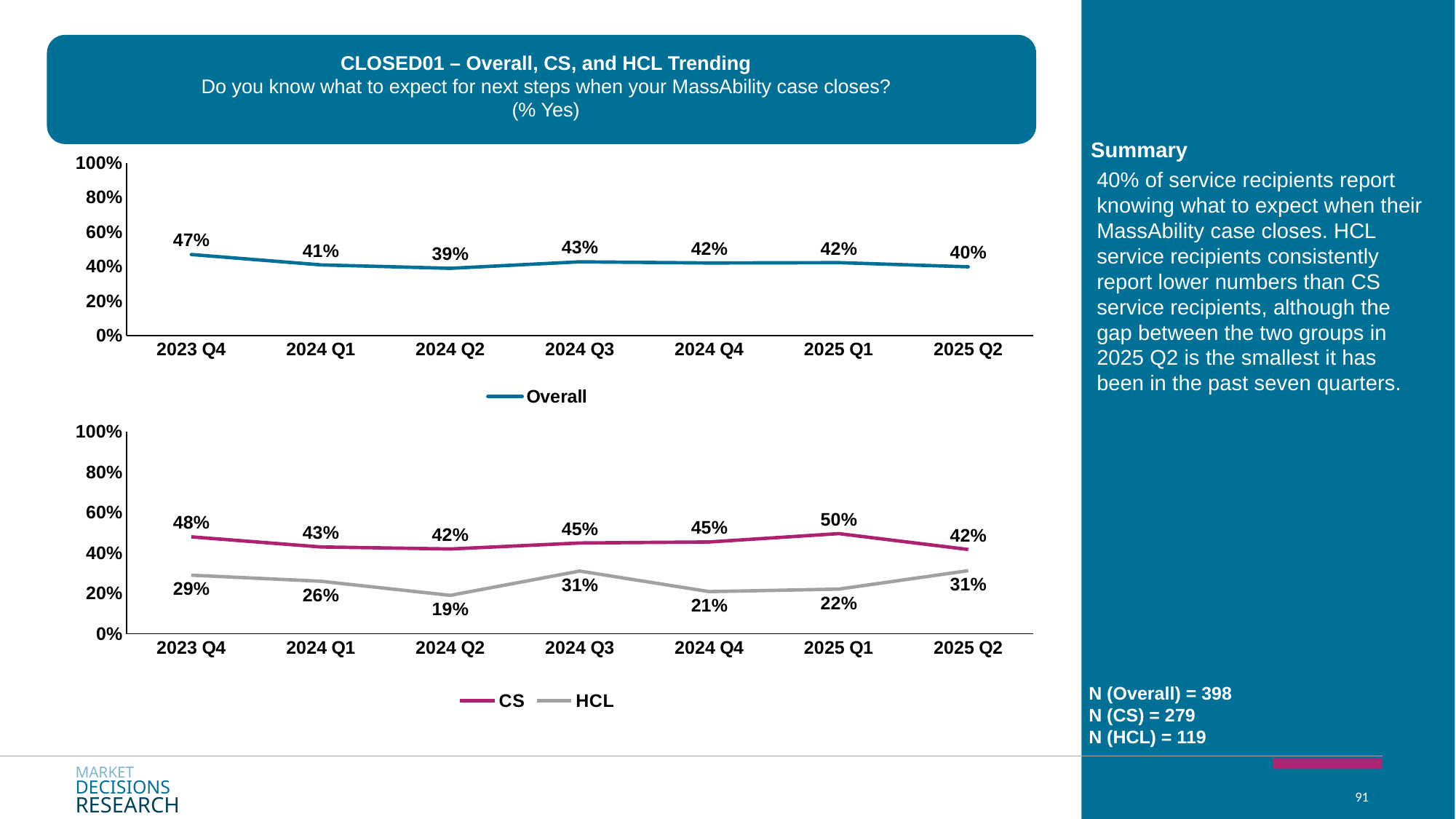
What type of chart is the top chart? Line chart In the bottom chart, which quarter has the highest CS value? 2025 Q1 How many series does the legend of the bottom chart list? 2 In the top chart (Overall), how many quarters are plotted? 7 In the bottom chart, what is the CS value for 2025 Q1? 50% In the top chart (Overall), what is the value for 2023 Q4? 47% In the top chart (Overall), what is the difference between the 2023 Q4 value and the 2025 Q2 value? 7 percentage points In the bottom chart, which quarter has the lowest HCL value? 2024 Q2 In the top chart (Overall), which quarter has the lowest value? 2024 Q2 In the bottom chart, what is the HCL value for 2024 Q2? 19% In the bottom chart, what is the difference between the CS and HCL values in 2025 Q2? 11 percentage points In the bottom chart, which is larger in 2024 Q4: the CS value or the HCL value? CS